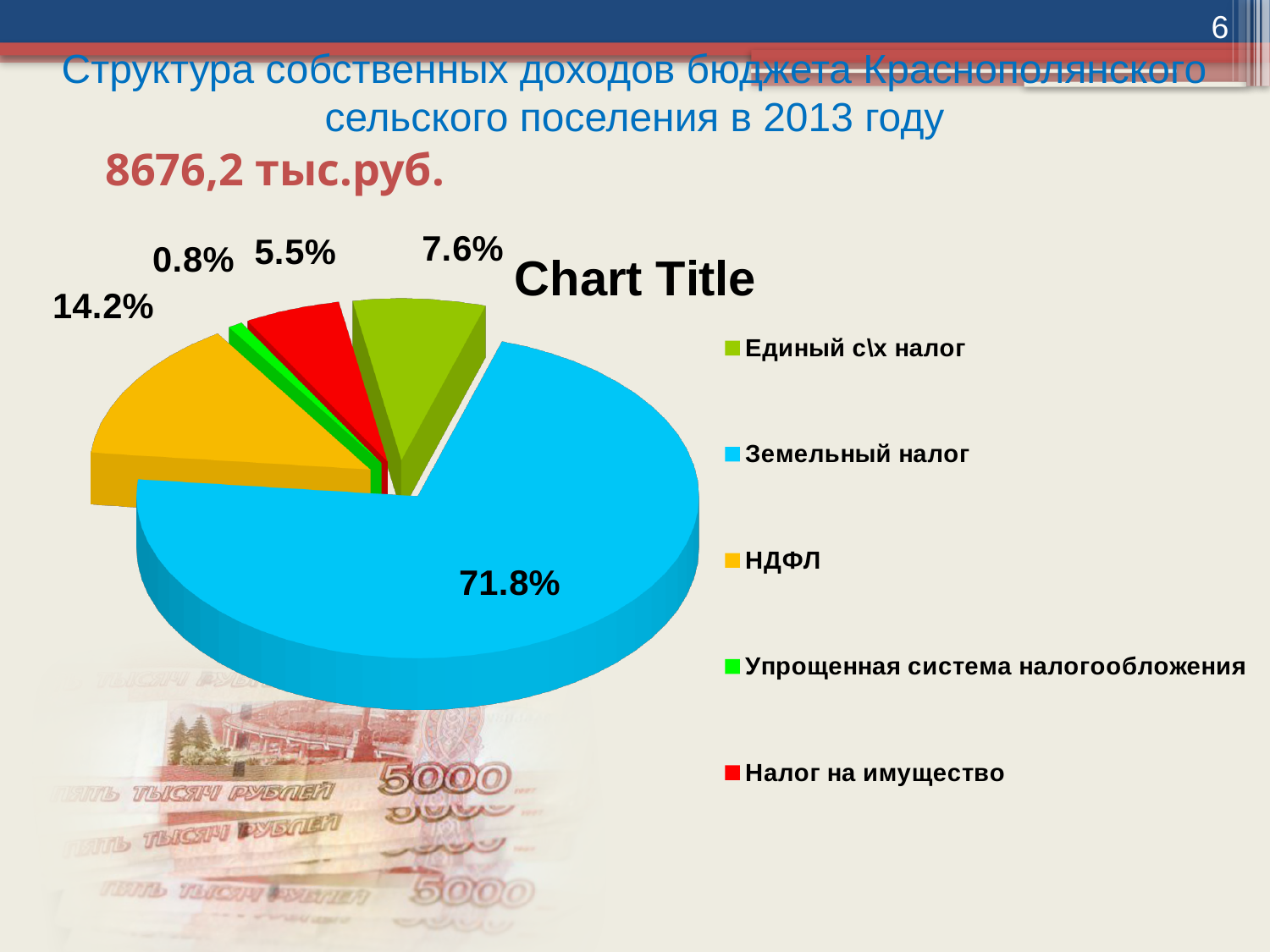
What is the title printed on the chart? Chart Title Which category has the smallest slice of the pie? Упрощенная система налогообложения What share of the pie does Единый с\х налог have? 7.6% What is the difference in percentage points between Земельный налог and НДФЛ? 57.6 What share of the pie does Налог на имущество have? 5.5% What share of the pie does НДФЛ have? 14.2% What share of the pie does Земельный налог have? 71.8% Which is larger, the share for Единый с\х налог or the share for Налог на имущество? Единый с\х налог Which category has the largest slice of the pie? Земельный налог How many categories does the legend list? 5 What share of the pie does Упрощенная система налогообложения have? 0.8% What kind of chart is shown on the slide? Pie chart